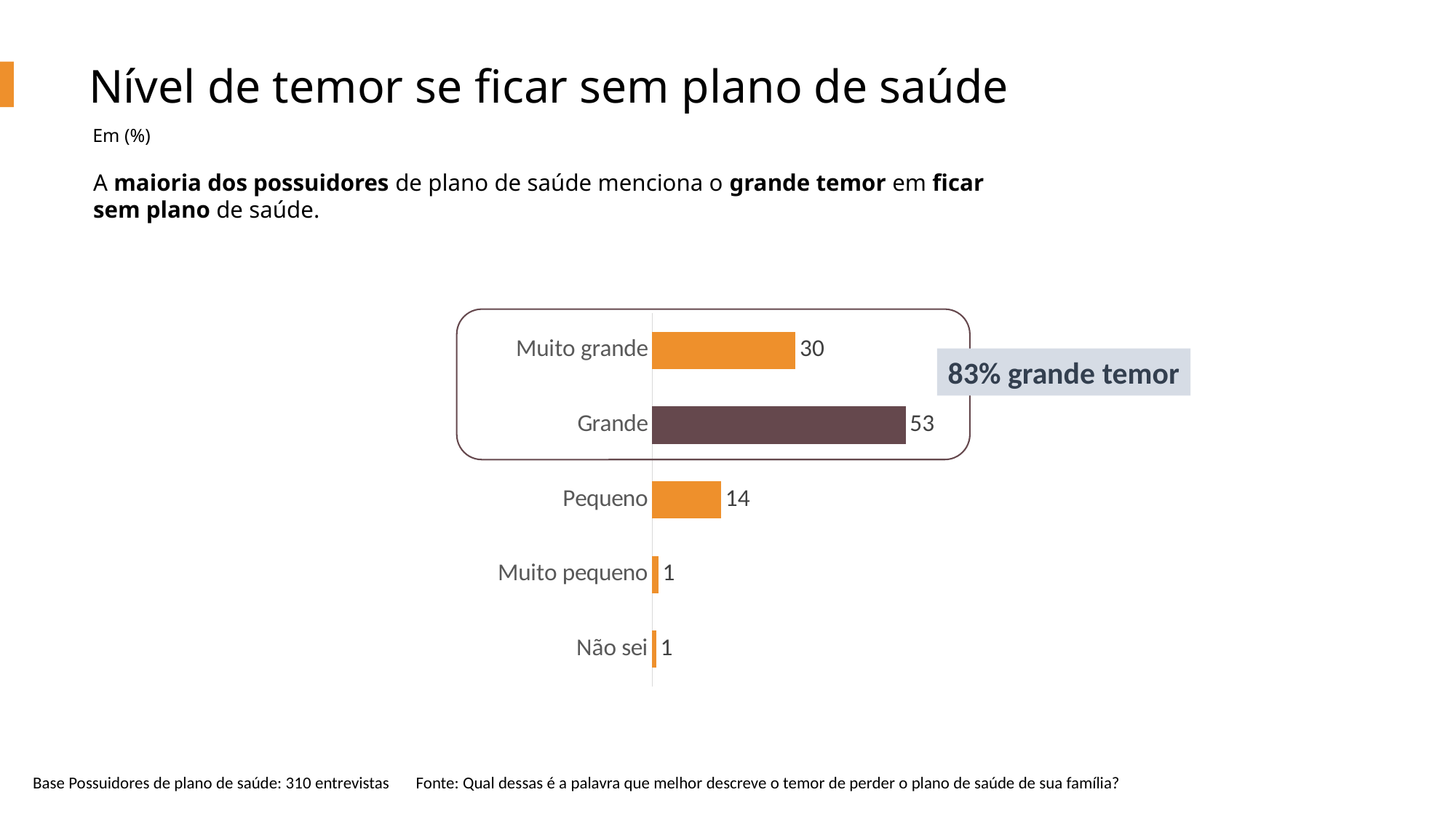
What is the value for "Grande"? 53 What is the title of the chart on the slide? Nível de temor se ficar sem plano de saúde How many categories are shown in the chart? 5 What is the value for "Muito grande"? 30 Which is larger, the value for "Pequeno" or the value for "Muito grande"? Muito grande Which category has the highest value? Grande What is the difference between the values for "Grande" and "Muito grande"? 23 What is the combined value of "Muito grande" and "Grande"? 83 What does the highlighted label next to the boxed bars say? 83% grande temor What is the value for "Pequeno"? 14 What is the value for "Muito pequeno"? 1 What kind of chart is shown on the slide? Bar chart